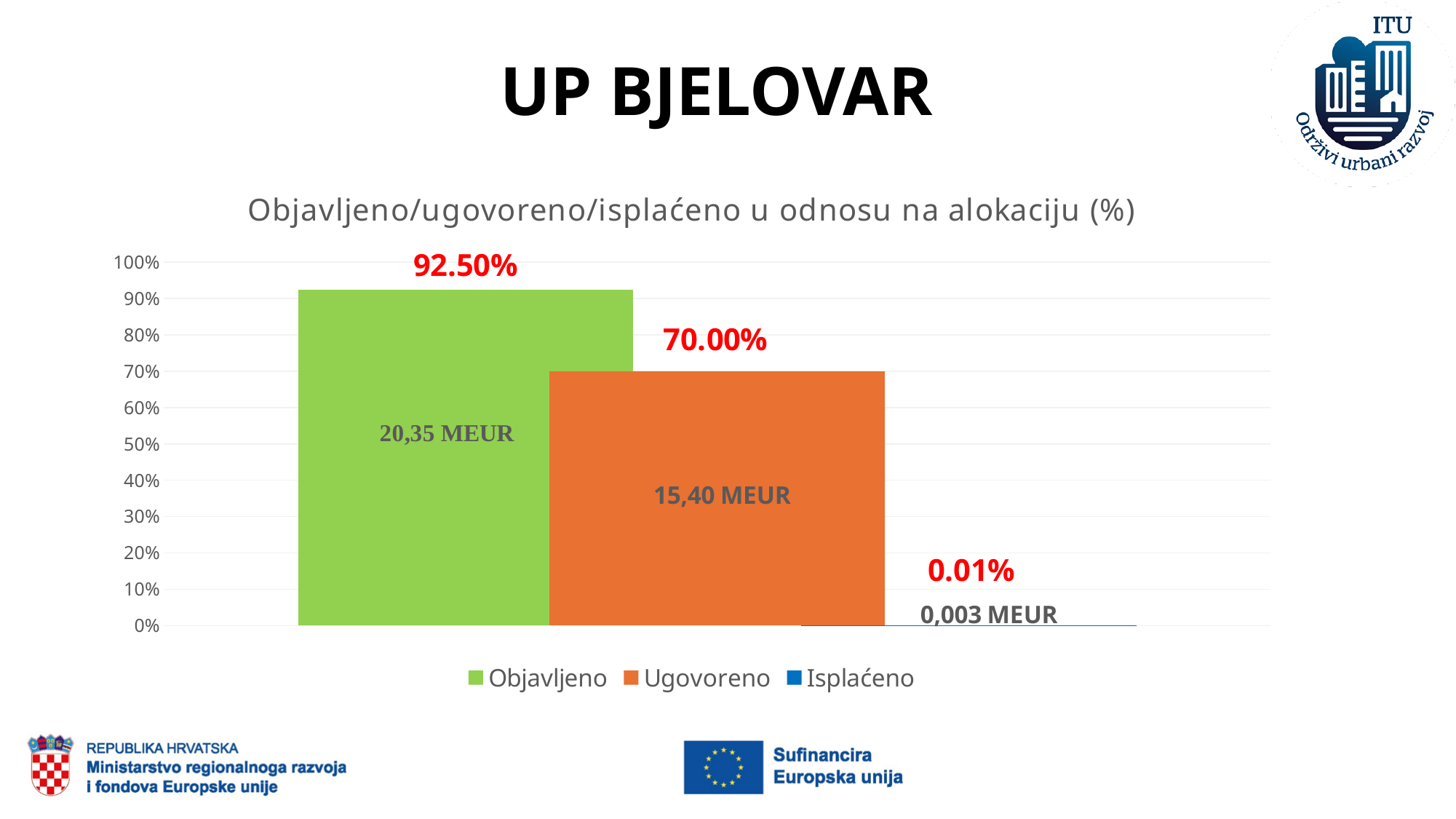
Which is larger, Ugovoreno or Isplaćeno? Ugovoreno Which series has the lowest percentage value? Isplaćeno What is the value for Objavljeno? 92.50% What is the value for Ugovoreno? 70.00% What amount in MEUR is shown for Objavljeno? 20,35 MEUR What type of chart is shown? Bar chart What is the difference in percentage points between Objavljeno and Ugovoreno? 22.50% How many series does the legend list? 3 What amount in MEUR is shown for Ugovoreno? 15,40 MEUR What amount in MEUR is shown for Isplaćeno? 0,003 MEUR What is the value for Isplaćeno? 0.01% Which series has the highest percentage value? Objavljeno